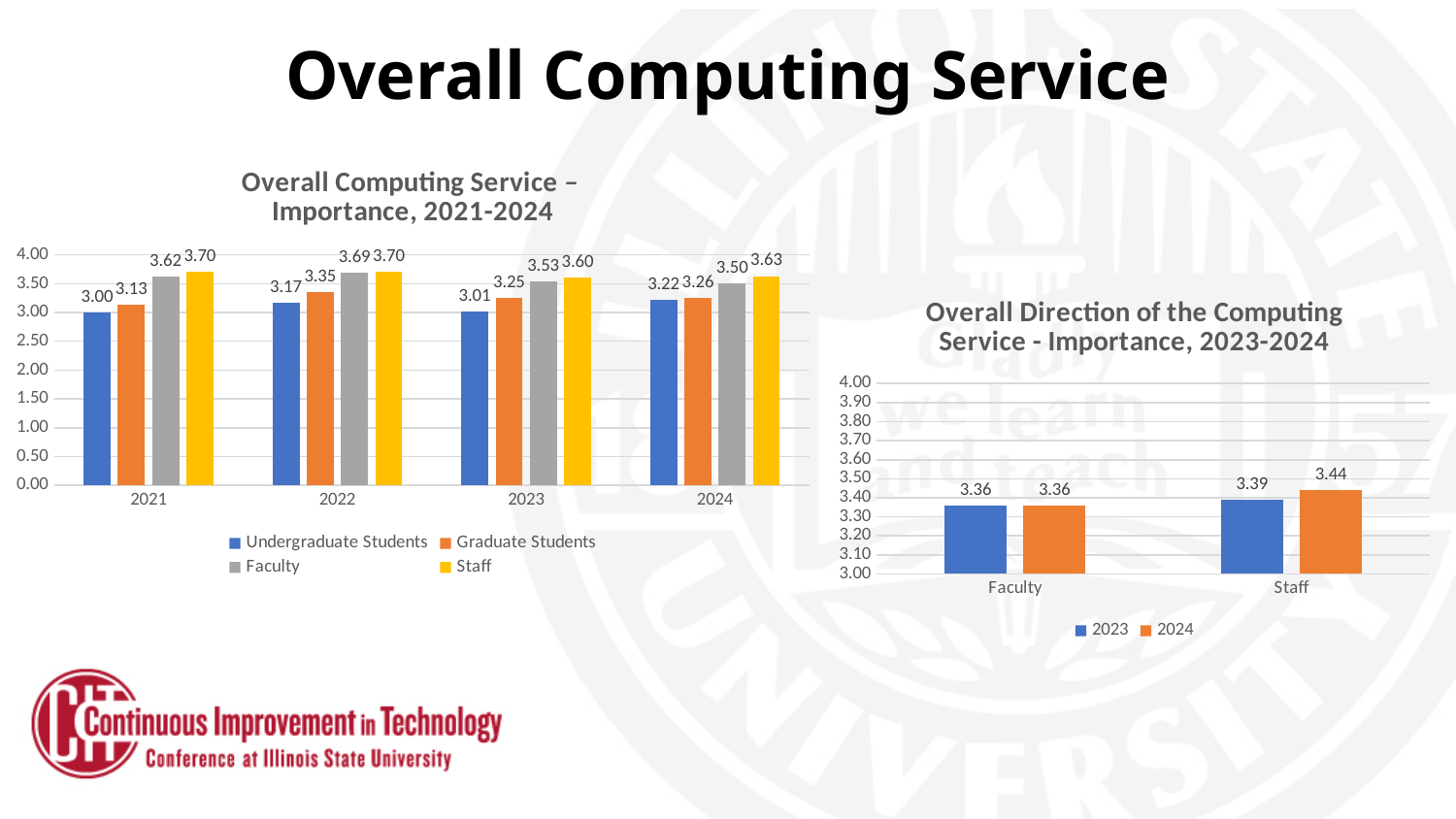
In the 'Overall Computing Service – Importance, 2021-2024' chart, how many years are shown on the x axis? 4 In the 'Overall Computing Service – Importance, 2021-2024' chart, what is the difference between the Staff and Undergraduate Students values in 2021? 0.70 In the 'Overall Computing Service – Importance, 2021-2024' chart, which group has the lowest value in 2022? Undergraduate Students In the 'Overall Computing Service – Importance, 2021-2024' chart, what is the value for Graduate Students in 2024? 3.26 In the 'Overall Direction of the Computing Service - Importance, 2023-2024' chart, what is the value for Staff in 2024? 3.44 In the 'Overall Direction of the Computing Service - Importance, 2023-2024' chart, is the 2023 value for Faculty larger than, smaller than, or equal to the 2024 value for Faculty? equal In the 'Overall Computing Service – Importance, 2021-2024' chart, which group has the highest value in 2023? Staff In the 'Overall Computing Service – Importance, 2021-2024' chart, what is the value for Undergraduate Students in 2021? 3.00 What kind of chart is the 'Overall Direction of the Computing Service - Importance, 2023-2024' chart? bar chart In the 'Overall Computing Service – Importance, 2021-2024' chart, how many series does the legend list? 4 In the 'Overall Direction of the Computing Service - Importance, 2023-2024' chart, what is the difference between the Staff values for 2024 and 2023? 0.05 In the 'Overall Computing Service – Importance, 2021-2024' chart, what is the value for Faculty in 2022? 3.69